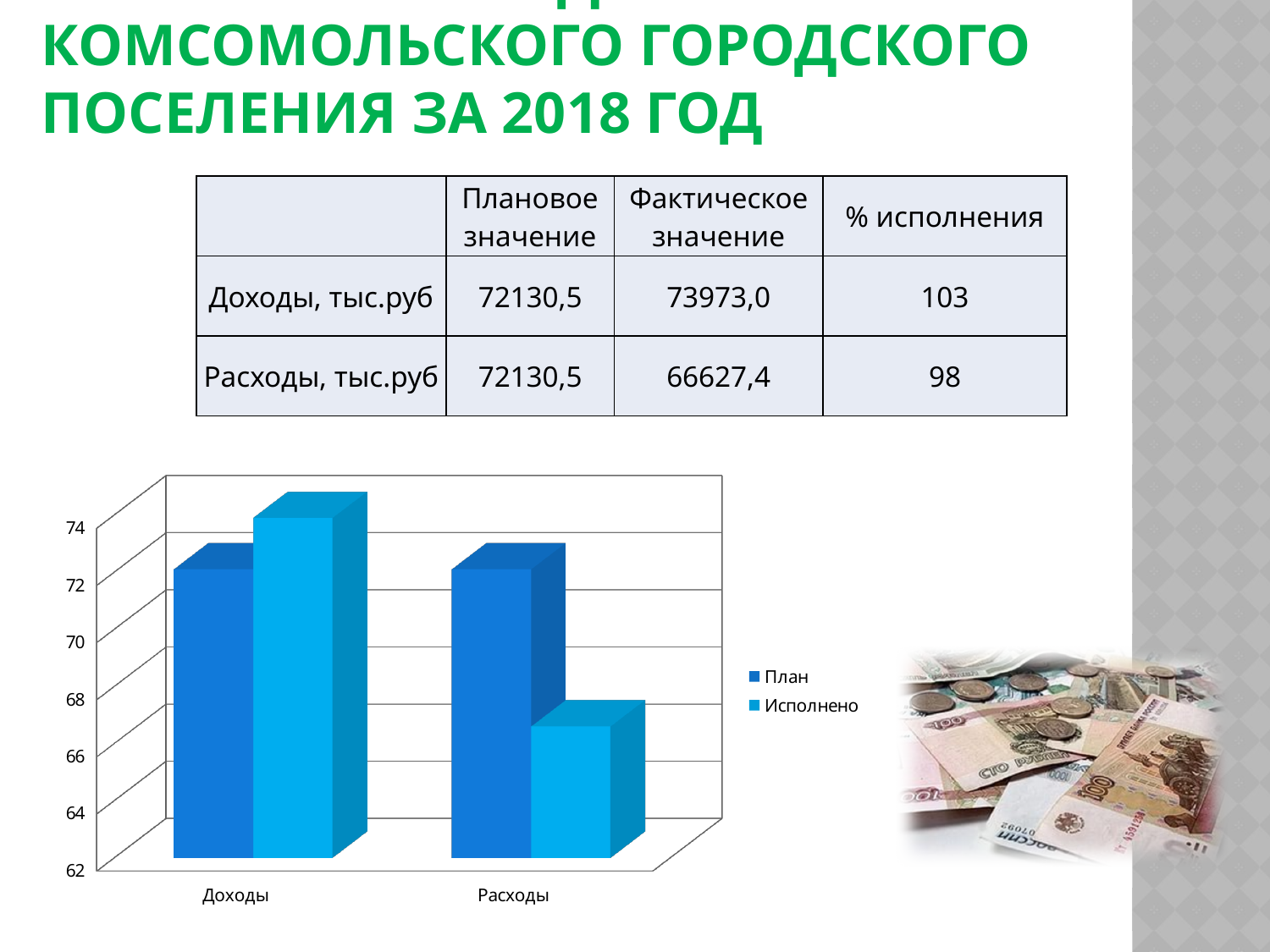
Is the Исполнено value for Расходы greater or less than 68? less Is the План value for Доходы greater or less than 70? greater Is the Исполнено value for Доходы greater or less than 72? greater How many series does the chart legend list? 2 For Доходы, which is larger in the chart: План or Исполнено? Исполнено What kind of chart is shown on the slide? bar chart Which bar is the tallest in the chart? Исполнено for Доходы For Расходы, which is larger in the chart: План or Исполнено? План What are the two series named in the chart legend? План, Исполнено How many categories are shown on the x axis of the chart? 2 Which category has the lowest bar in the chart? Расходы (Исполнено)